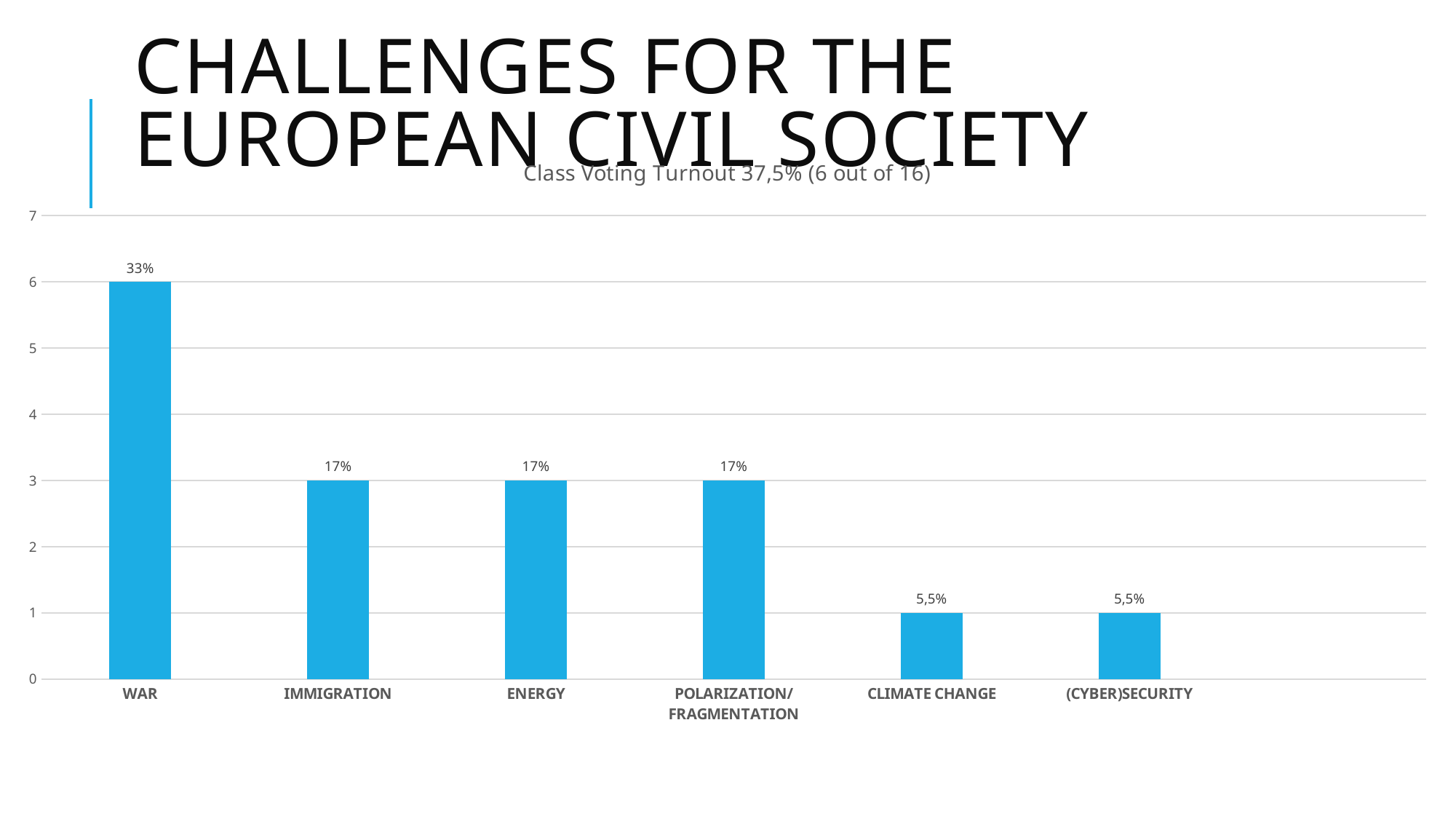
What is the data label shown on the WAR bar? 33% Which is larger, the value for WAR or the value for ENERGY? WAR What kind of chart is shown on the slide? bar chart How many categories are shown on the x axis? 6 Which is larger, the value for POLARIZATION/FRAGMENTATION or the value for CLIMATE CHANGE? POLARIZATION/FRAGMENTATION What is the title of the chart? Class Voting Turnout 37,5% (6 out of 16) What is the data label shown on the CLIMATE CHANGE bar? 5,5% What is the data label shown on the IMMIGRATION bar? 17% Which category has the highest bar? WAR On the vertical axis, how many units higher does the WAR bar reach than the IMMIGRATION bar? 3 Is the value for ENERGY on the vertical axis greater or less than 2? greater What is the data label shown on the (CYBER)SECURITY bar? 5,5%